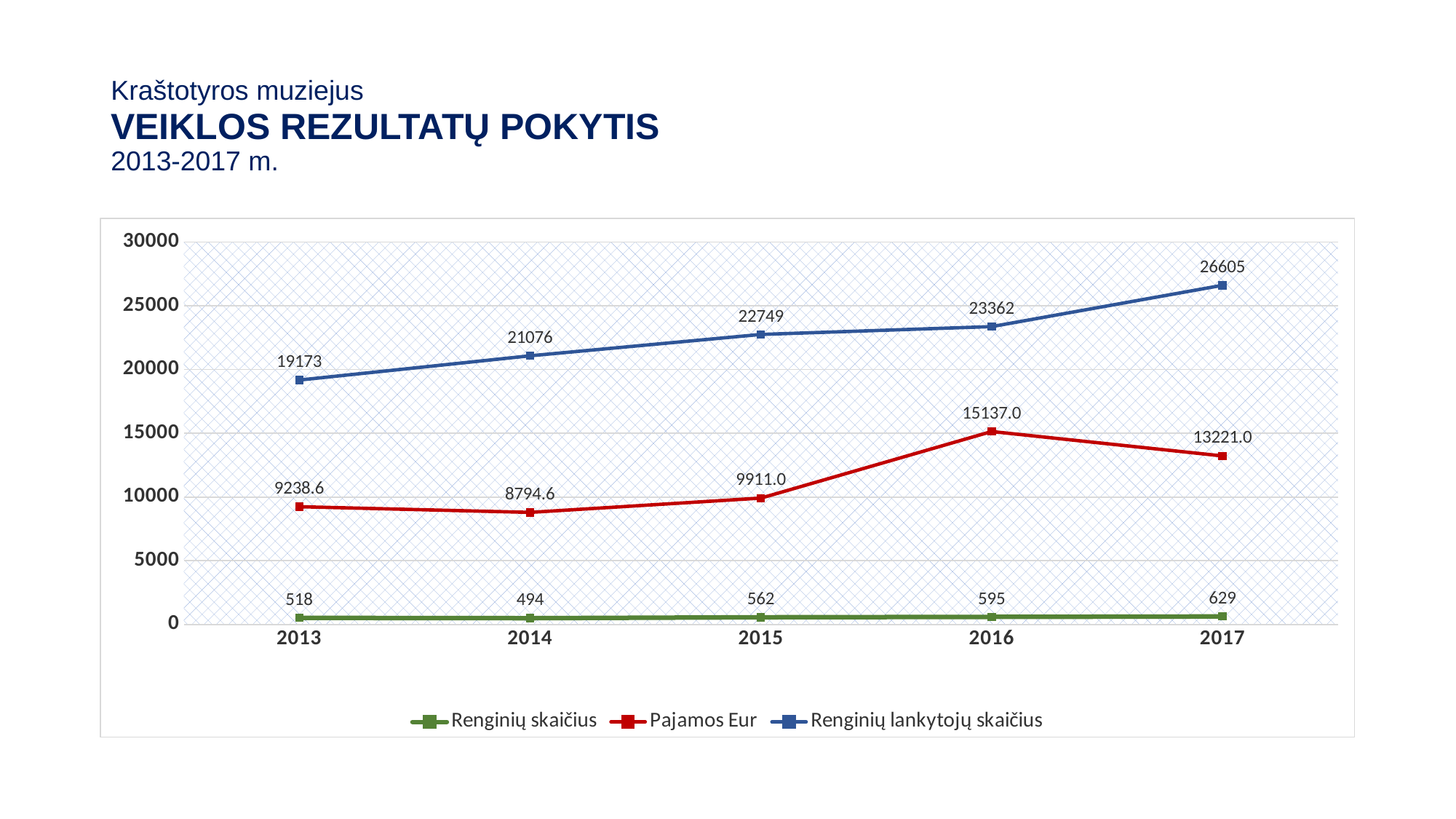
Which colour is used for the Pajamos Eur series? red What is the value of Renginių lankytojų skaičius in 2015? 22749 Does Renginių lankytojų skaičius rise or fall from 2013 to 2017? rise What is the value of Pajamos Eur in 2014? 8794.6 What kind of chart is shown on the slide? line chart What is the value of Renginių skaičius in 2017? 629 In which year is Renginių skaičius lowest? 2014 How many series does the legend list? 3 In which year is Pajamos Eur highest? 2016 How many years are plotted on the x axis? 5 Which is larger, Pajamos Eur in 2016 or in 2017? 2016 What is the difference in Renginių lankytojų skaičius between 2017 and 2013? 7432